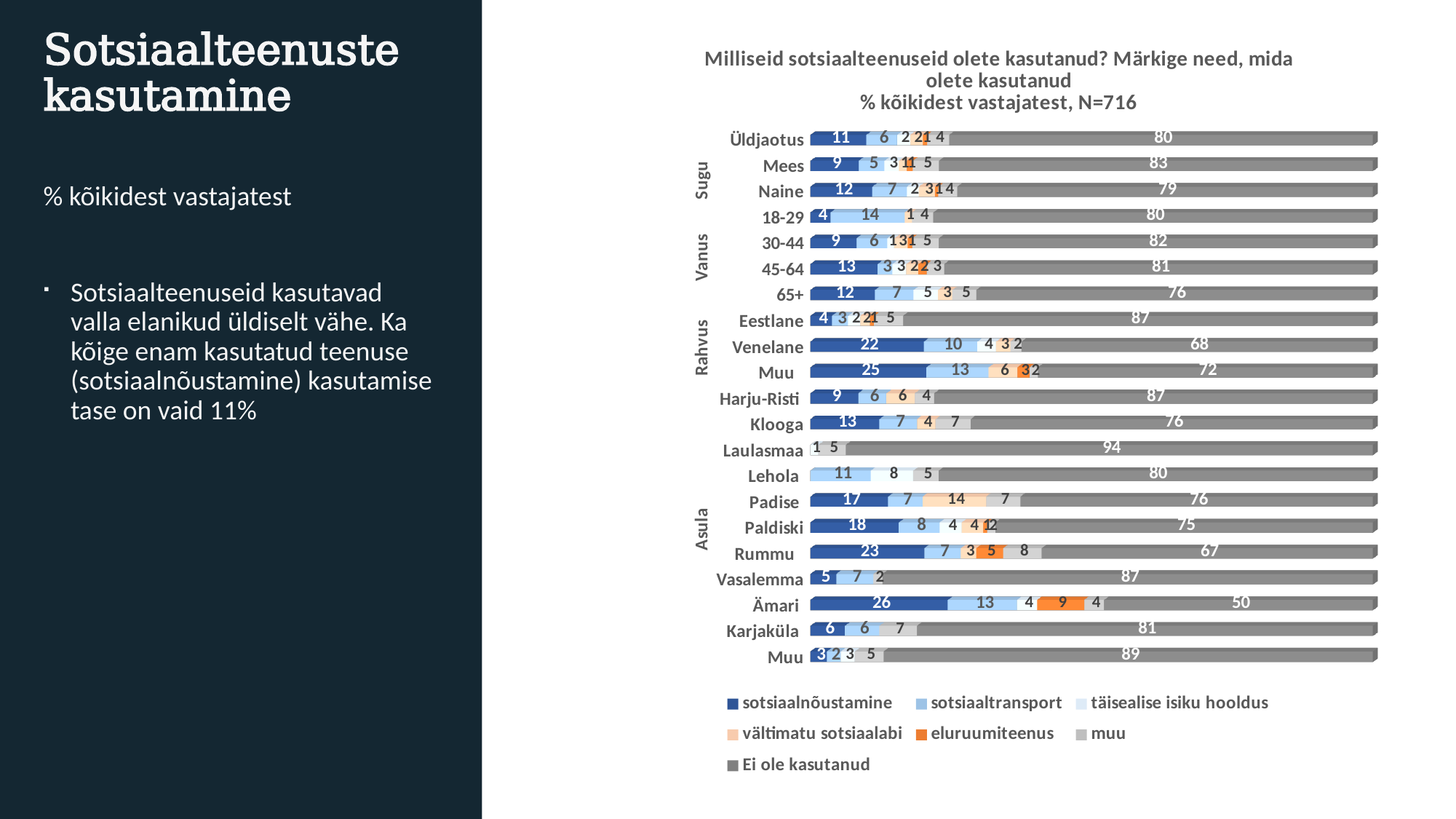
What sample size (N) is stated in the chart title? N=716 Which category has the lowest 'Ei ole kasutanud' value? Ämari What is the difference between the 'Ei ole kasutanud' values for Mees and Naine? 4 What is the 'Ei ole kasutanud' value for Ämari? 50 What is the 'sotsiaalnõustamine' value for Üldjaotus? 11 What kind of chart is shown on the slide? Stacked bar chart What is the 'eluruumiteenus' value for Ämari? 9 How many series does the chart legend list? 7 What is the 'sotsiaalnõustamine' value for Venelane? 22 Which has a larger 'sotsiaalnõustamine' value, Rummu or Padise? Rummu Which category has the highest 'Ei ole kasutanud' value? Laulasmaa What is the 'vältimatu sotsiaalabi' value for Padise? 14